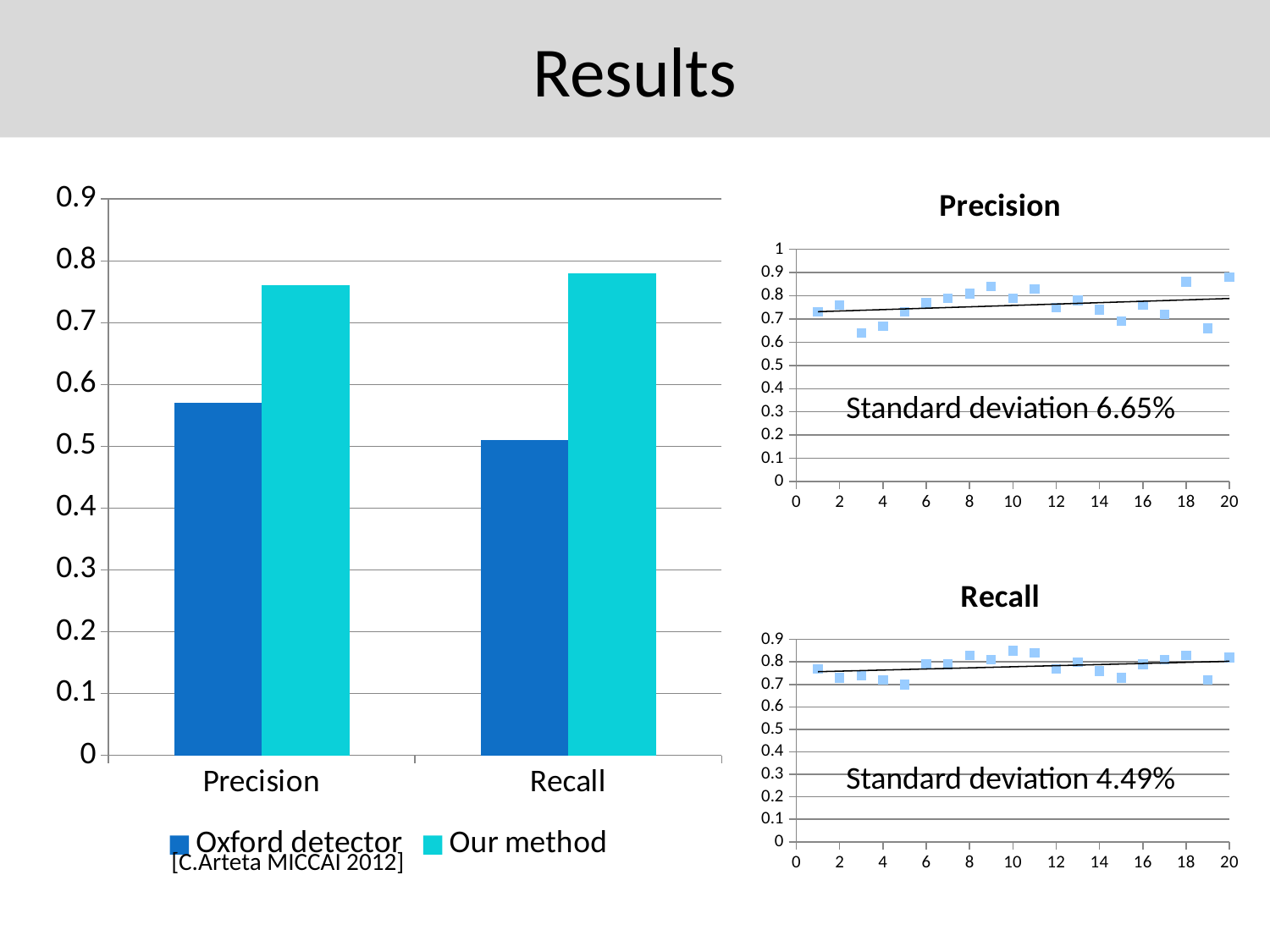
In the bar chart on the left, which series has the larger Precision value, Oxford detector or Our method? Our method In the chart titled Recall on the right, what standard deviation is stated? 4.49% In the bar chart on the left, how many series does the legend list? 2 In the bar chart on the left, which series has the larger Recall value, Oxford detector or Our method? Our method In the bar chart on the left, how many categories are shown on the x axis? 2 What kind of chart is the large chart on the left of the slide? bar chart In the bar chart on the left, what are the two legend entries? Oxford detector, Our method In the bar chart on the left, is the Precision value for Our method greater or less than 0.7? greater In the bar chart on the left, is the Recall value for Oxford detector greater or less than 0.6? less In the chart titled Precision on the right, how many data points are plotted? 20 In the bar chart on the left, which bar is the lowest? Oxford detector, Recall In the chart titled Precision on the right, does the trend line rise or fall from left to right? rise